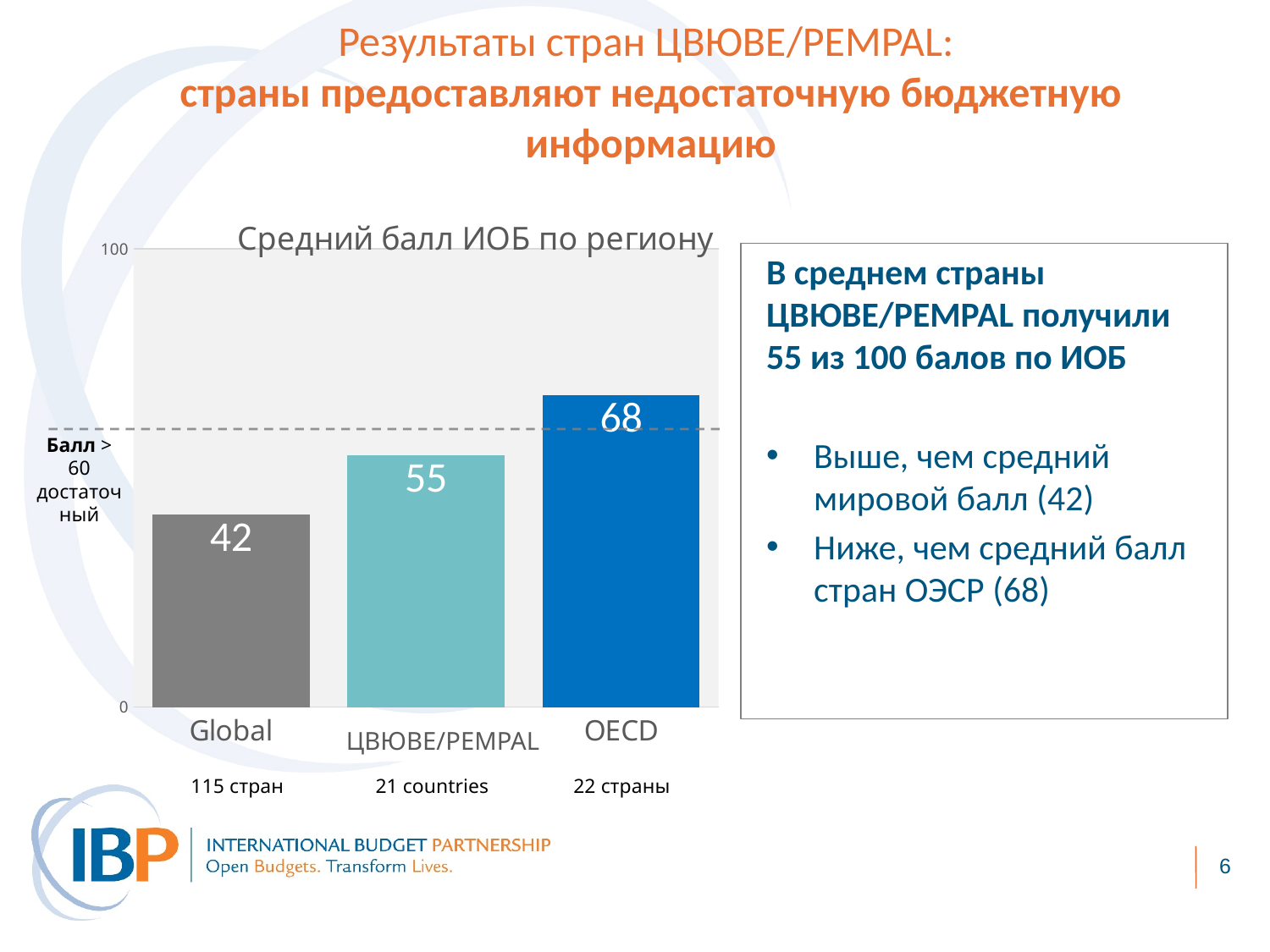
What is the difference between the OECD score and the Global score? 26 What is the title of the chart? Средний балл ИОБ по региону What kind of chart is shown on the slide? bar chart What is the average OBI score for the Global category? 42 Is the value for ЦВЮВЕ/PEMPAL greater or less than 60? less What is the average OBI score for OECD? 68 Which category has the highest average OBI score? OECD What is the difference between the ЦВЮВЕ/PEMPAL score and the Global score? 13 What is the average OBI score for ЦВЮВЕ/PEMPAL? 55 Which category has the lowest average OBI score? Global How many categories are shown in the chart? 3 Which is larger, the score for ЦВЮВЕ/PEMPAL or the score for OECD? OECD